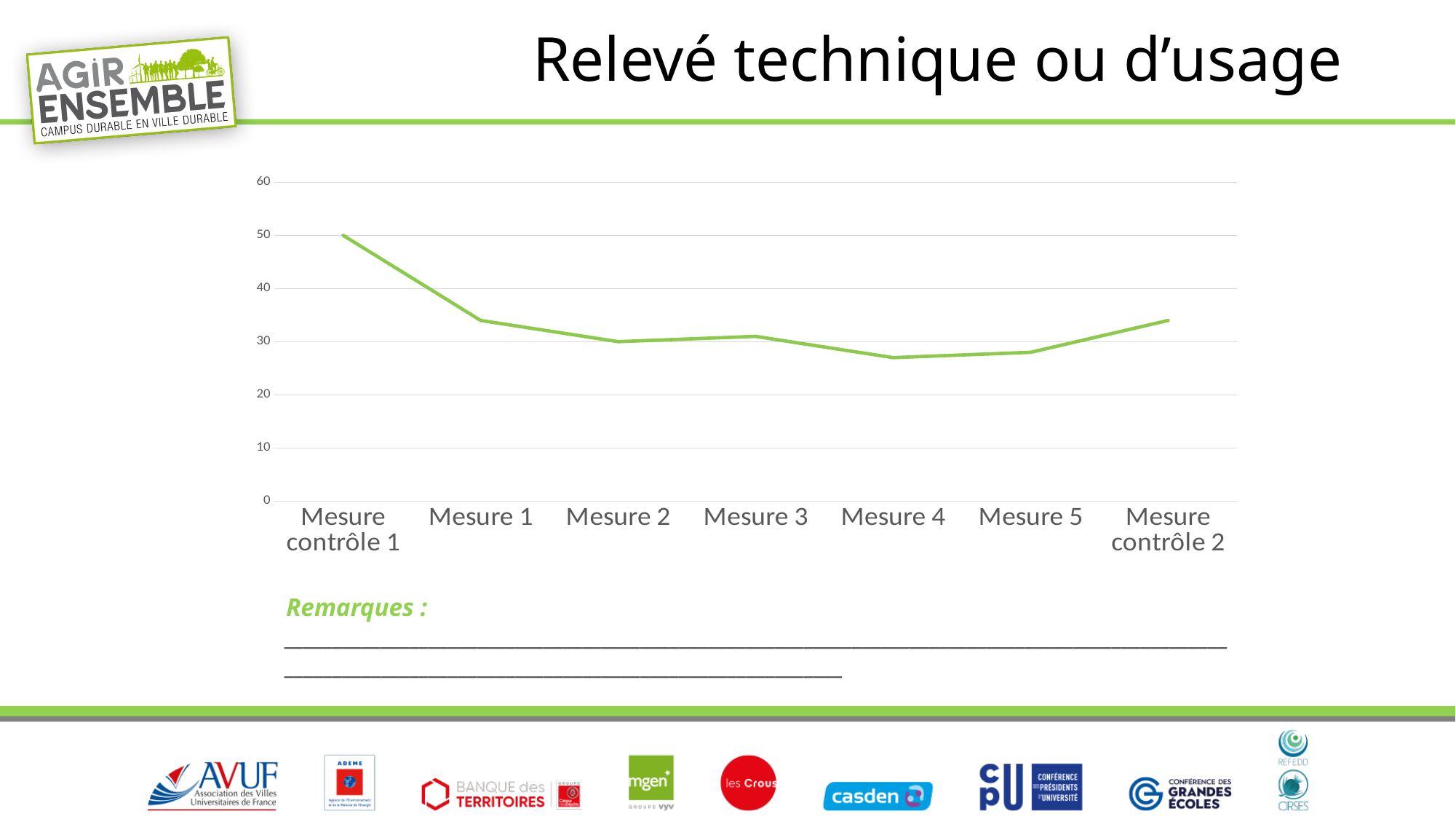
What is the highest value shown on the vertical axis of the chart? 60 Do the values rise or fall from Mesure contrôle 1 to Mesure 4? fall What is the value for Mesure 2? 30 Which category has the highest value? Mesure contrôle 1 Is the value for Mesure 4 greater or less than 30? less Is the value for Mesure contrôle 2 greater or less than 40? less Which is larger, the value for Mesure contrôle 1 or the value for Mesure 1? Mesure contrôle 1 What is the value for Mesure contrôle 1? 50 What kind of chart is shown on the slide? line chart Is the value for Mesure 1 greater or less than 30? greater How many points are plotted along the x axis of the chart? 7